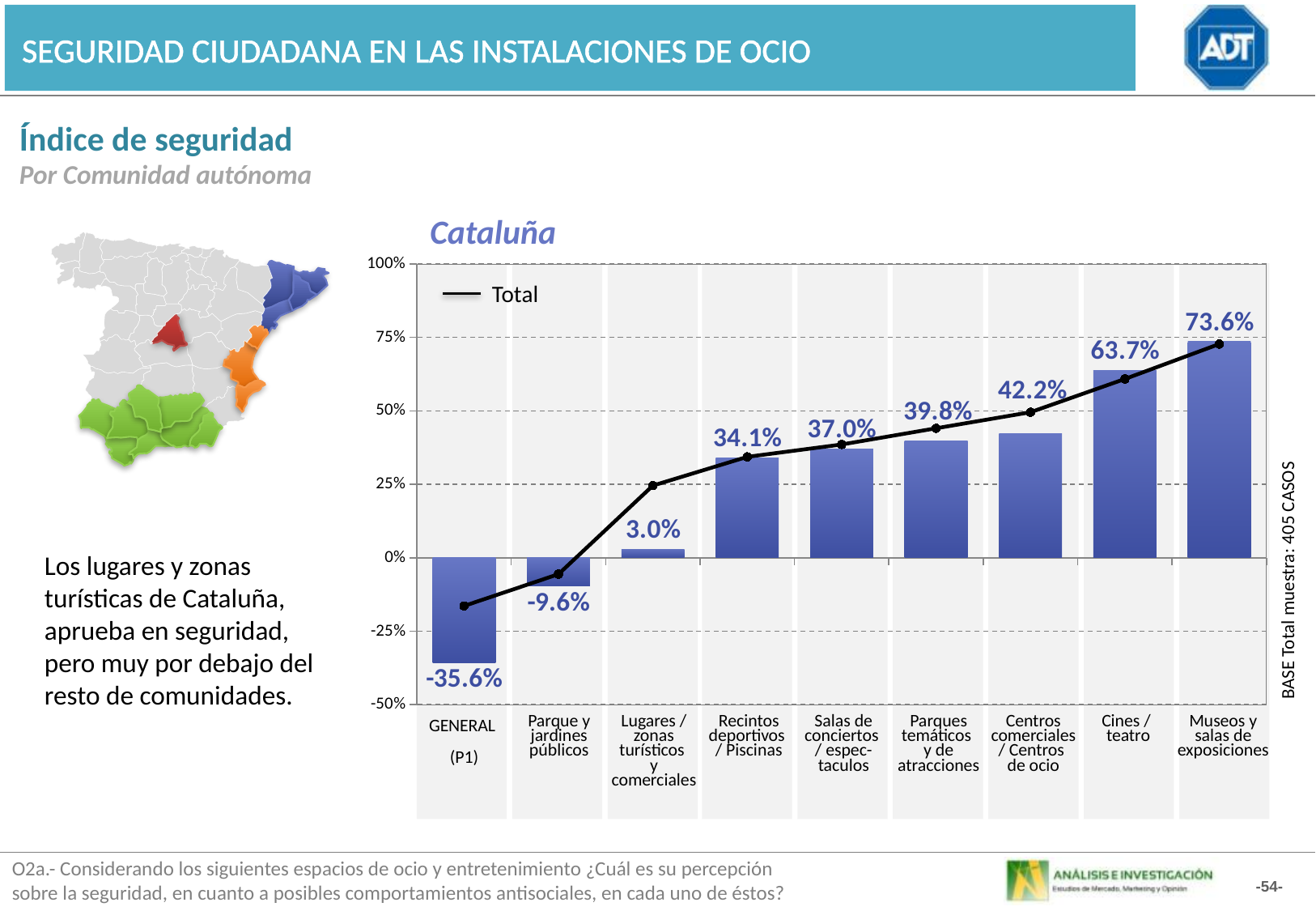
Which is larger, the value for Recintos deportivos / Piscinas or Salas de conciertos / espectáculos? Salas de conciertos / espectáculos What is the value for Museos y salas de exposiciones in the Cataluña chart? 73.6% Which category has the highest value in the Cataluña chart? Museos y salas de exposiciones How many series does the legend list? 1 What is the difference between the values for Cines / teatro and Centros comerciales / Centros de ocio? 21.5% Which category has the lowest value in the Cataluña chart? GENERAL (P1) Do the bar values rise or fall from left to right along the x axis? Rise Is the Total line value for Lugares / zonas turísticos y comerciales greater or less than 0%? greater What is the value for Parques temáticos y de atracciones? 39.8% How many categories are shown on the x axis of the Cataluña chart? 9 What is the value for GENERAL (P1) in the Cataluña chart? -35.6% What kind of chart is used for the Cataluña data? Bar chart with a line